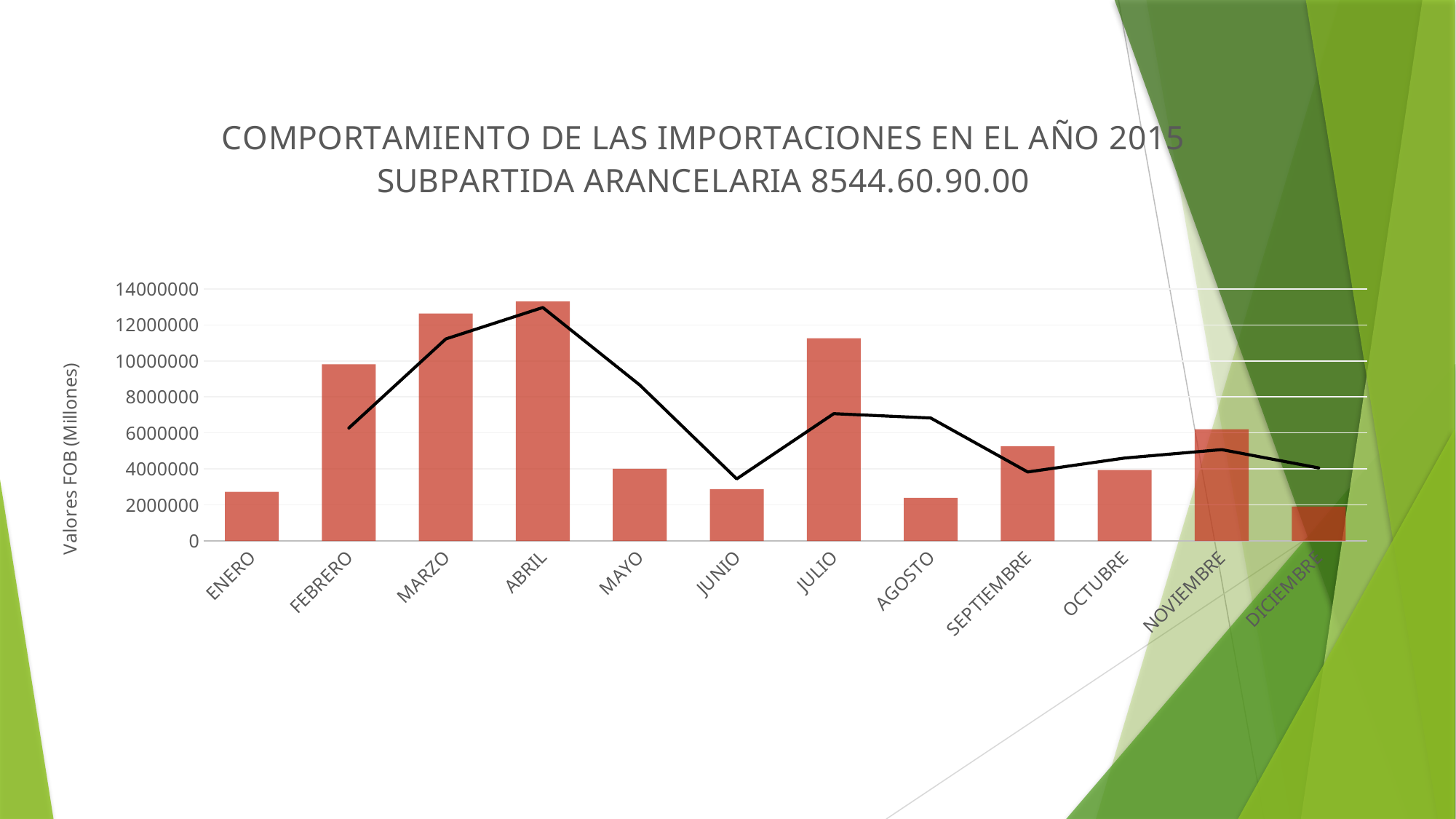
Is the value for SEPTIEMBRE greater or less than 4000000? greater Which month has the larger bar, JULIO or MAYO? JULIO Is the value for JULIO greater or less than 10000000? greater Which month has the larger bar, MARZO or FEBRERO? MARZO Which month has the highest bar in the chart? ABRIL Is the value for AGOSTO greater or less than 4000000? less How many months are shown on the x axis of the chart? 12 What is the label of the vertical axis of the chart? Valores FOB (Millones) Do the bar values rise or fall from ABRIL to JUNIO? fall What kind of chart is shown on the slide? Bar chart with a line overlay